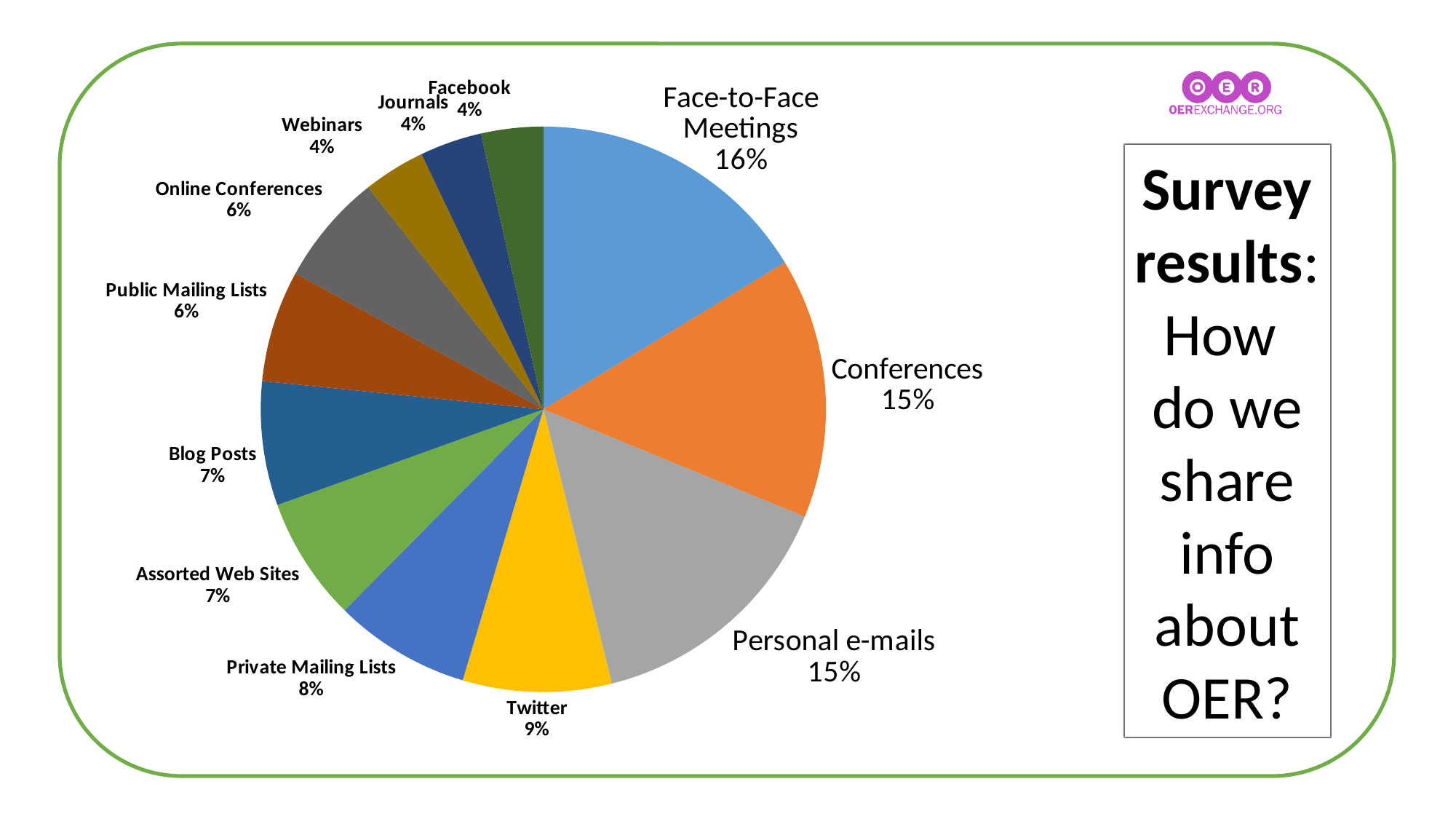
Which is larger, the share for Twitter or the share for Private Mailing Lists? Twitter What is the difference in percentage points between Face-to-Face Meetings and Twitter? 7 What share of the pie is Face-to-Face Meetings? 16% Which category has the largest share of the pie? Face-to-Face Meetings What percentage is shown for Private Mailing Lists? 8% What percentage is shown for Webinars? 4% What kind of chart is shown on the slide? pie chart How many categories (slices) does the pie chart have? 12 What question does the text box next to the chart say the survey results answer? How do we share info about OER? What percentage is shown for Twitter? 9% What percentage is shown for Online Conferences? 6% Which is larger, the share for Conferences or the share for Blog Posts? Conferences